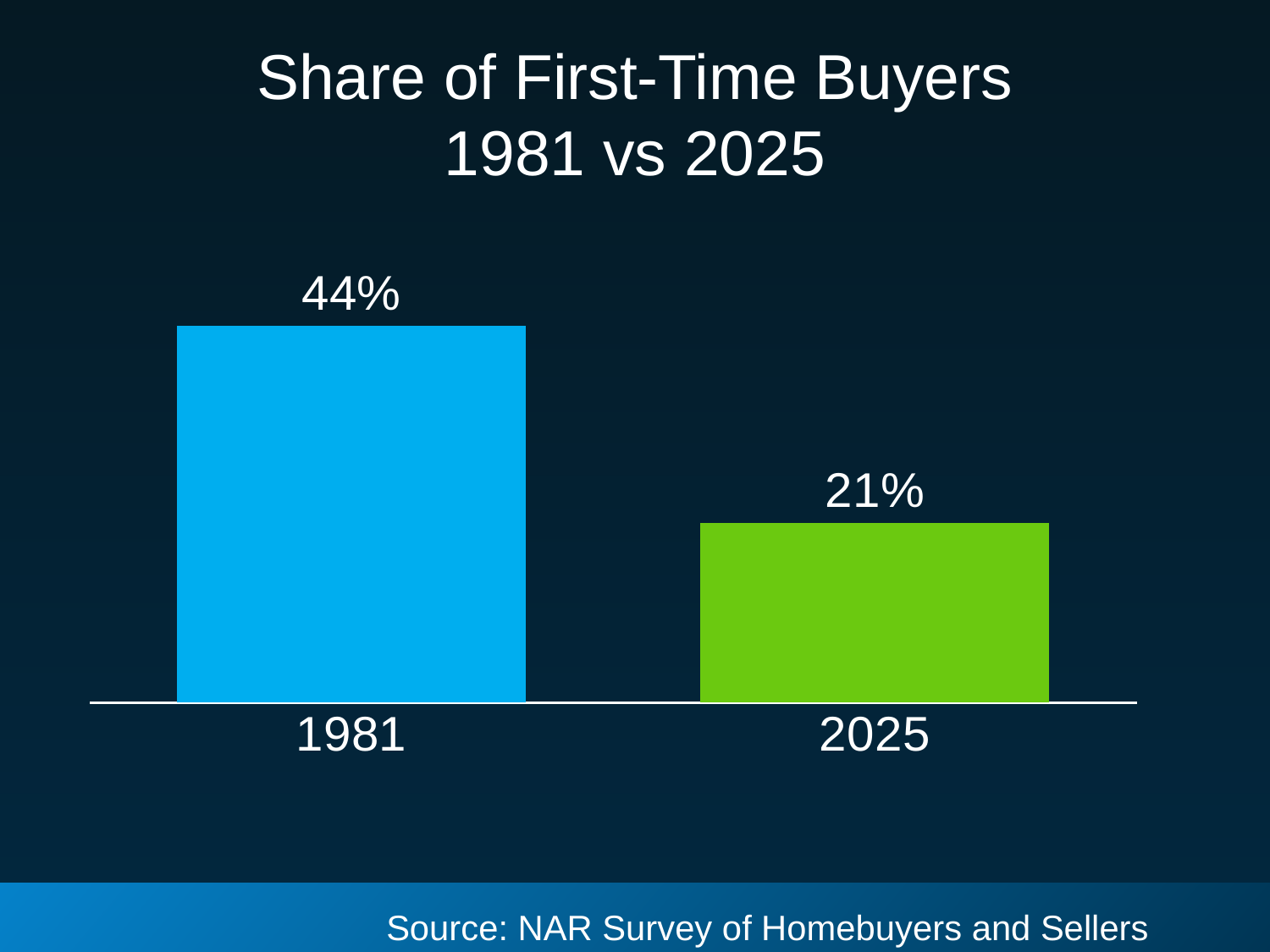
How many years are shown on the chart? 2 What is the share of first-time buyers in 2025? 21% What is the share of first-time buyers in 1981? 44% Which year has the lower share of first-time buyers? 2025 By how many percentage points does the 1981 share exceed the 2025 share? 23 percentage points Which year has the higher share of first-time buyers? 1981 What is the title of the chart? Share of First-Time Buyers 1981 vs 2025 What kind of chart is shown on the slide? Bar chart What colour is the bar for 2025? Green Is the share of first-time buyers larger in 1981 or in 2025? 1981 Does the share of first-time buyers rise or fall from 1981 to 2025? Fall